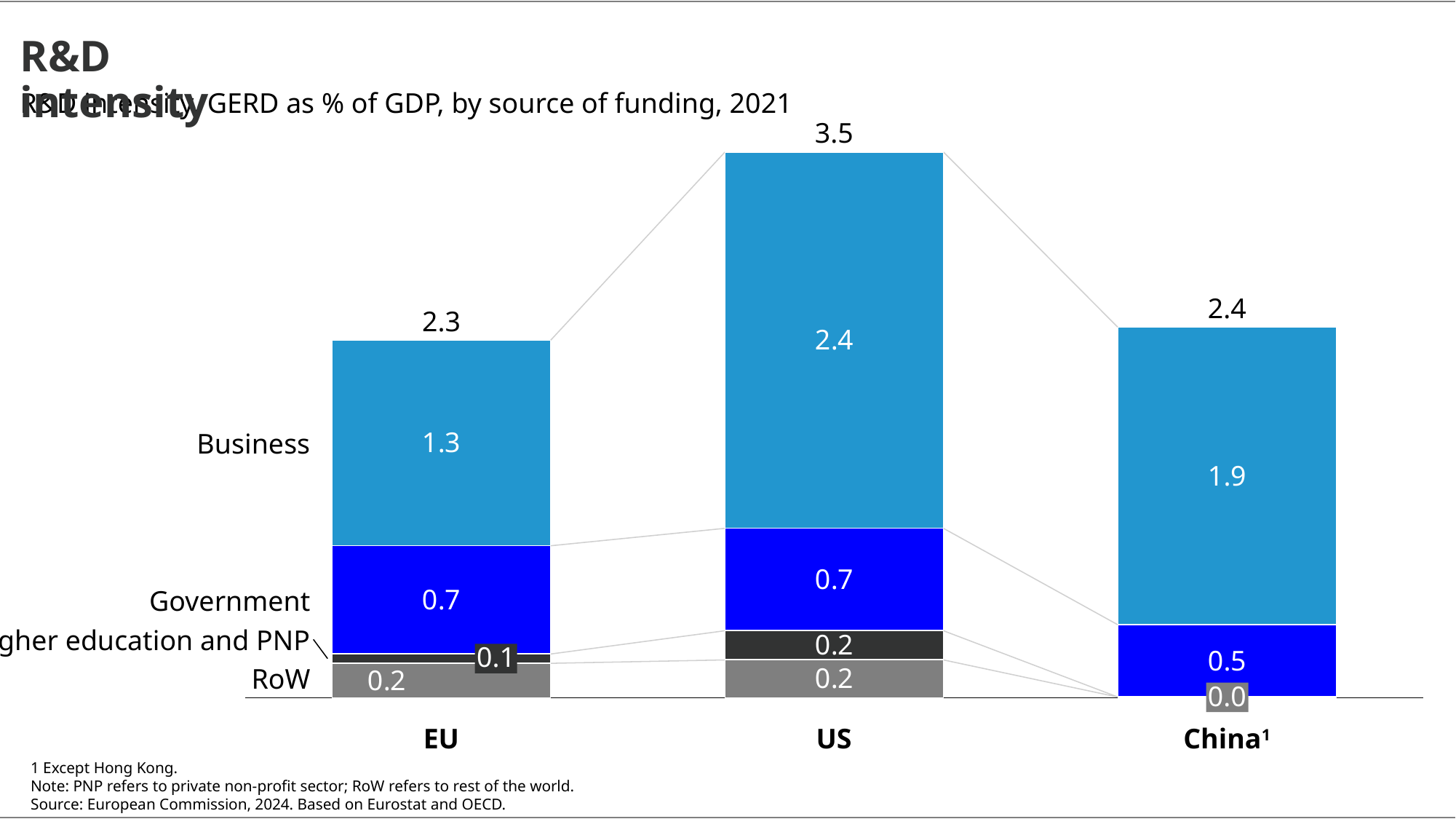
How many funding sources are stacked in each bar? 4 What is the Business-funded value for the US? 2.4 What is the RoW value for the US? 0.2 What is the total R&D intensity shown for the US? 3.5 What is the Government-funded value for China? 0.5 What is the difference between the total R&D intensity of the US and the EU? 1.2 Which region has the lowest total R&D intensity? EU How many regions are shown on the chart? 3 What kind of chart is shown on the slide? Stacked bar chart Which is larger, the Business-funded value for China or for the EU? China What is the Business-funded value for the EU? 1.3 Which region has the highest total R&D intensity? US